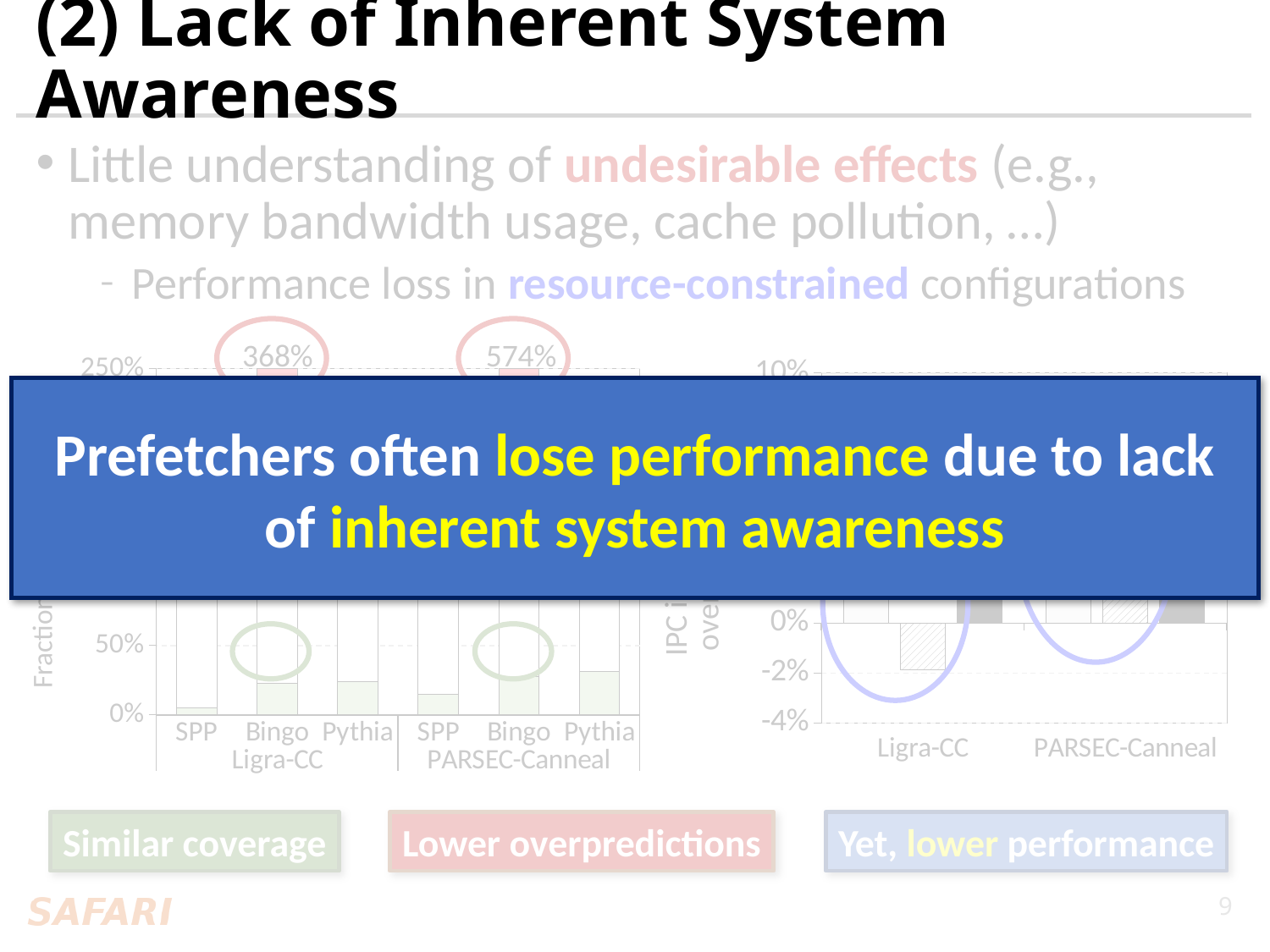
In the left chart, which is larger: the bar for SPP under Ligra-CC or the bar for Pythia under PARSEC-Canneal? Pythia under PARSEC-Canneal In the left chart, is the value for Pythia under PARSEC-Canneal greater or less than 50%? less In the left chart, what value is printed in the circled label above the PARSEC-Canneal group? 574% What kind of chart is the chart on the right of the slide? bar chart In the right chart, how many categories are labelled on the x axis? 2 In the left chart, how many prefetcher bars are shown along the x axis in total? 6 In the left chart, is the value for SPP under Ligra-CC greater or less than 50%? less In the left chart, which of the two circled labels is larger, 368% or 574%? 574% What kind of chart is the chart on the left of the slide? bar chart In the right chart, is the hatched bar for Ligra-CC greater or less than 0%? less In the left chart, which two benchmark groups are labelled on the x axis? Ligra-CC and PARSEC-Canneal In the left chart, what value is printed in the circled label above the Ligra-CC group? 368%